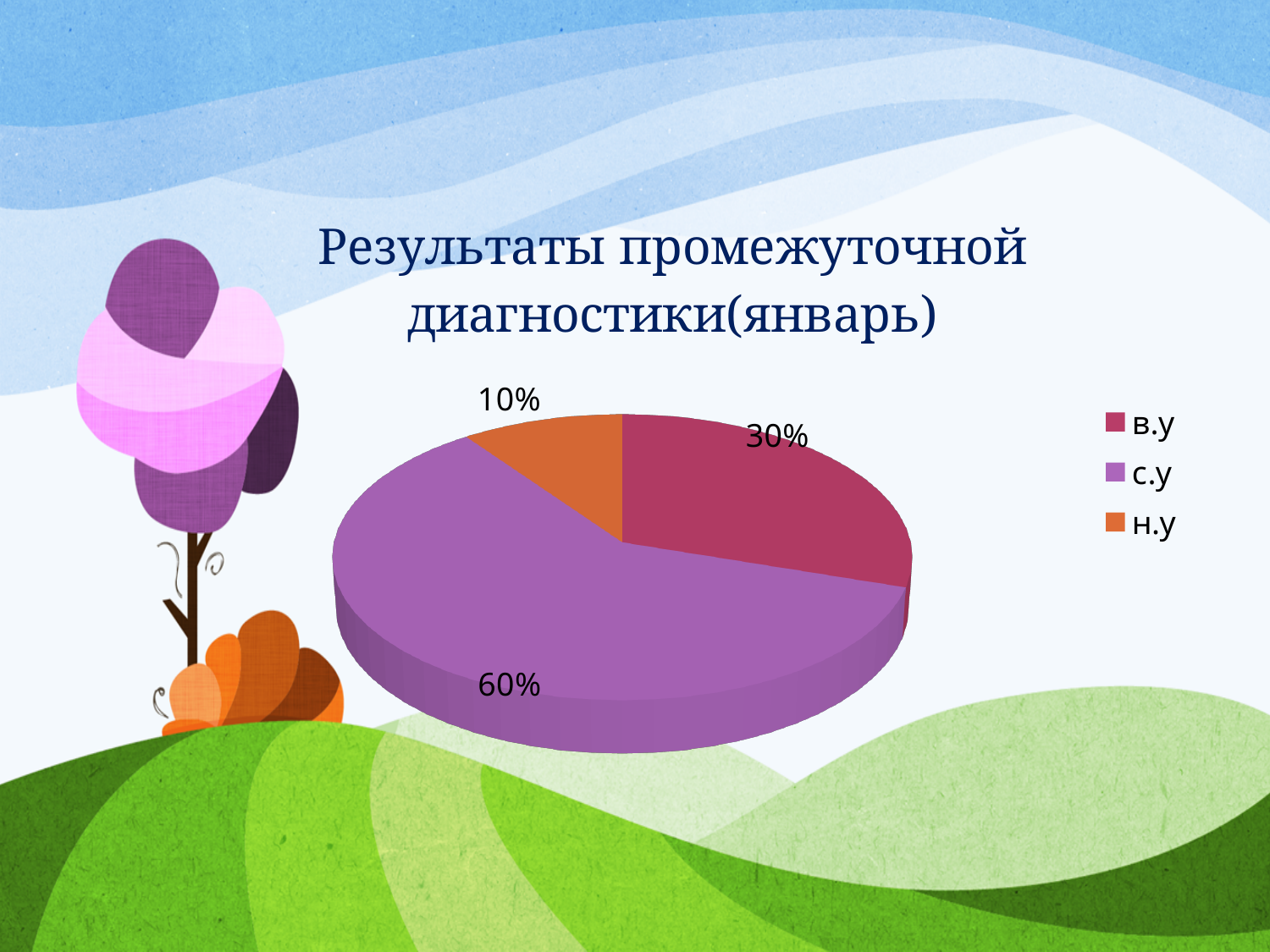
How many entries does the legend list? 3 What kind of chart is shown on the slide? pie chart What share of the pie does с.у have? 60% What is the title of the chart on the slide? Результаты промежуточной диагностики(январь) What share of the pie does в.у have? 30% What share of the pie does н.у have? 10% Which category has the largest slice of the pie? с.у What is the difference between the shares of с.у and в.у? 30% How many slices does the pie chart have? 3 What is the difference between the shares of в.у and н.у? 20% Which is larger, the share of в.у or the share of н.у? в.у Which category has the smallest slice of the pie? н.у